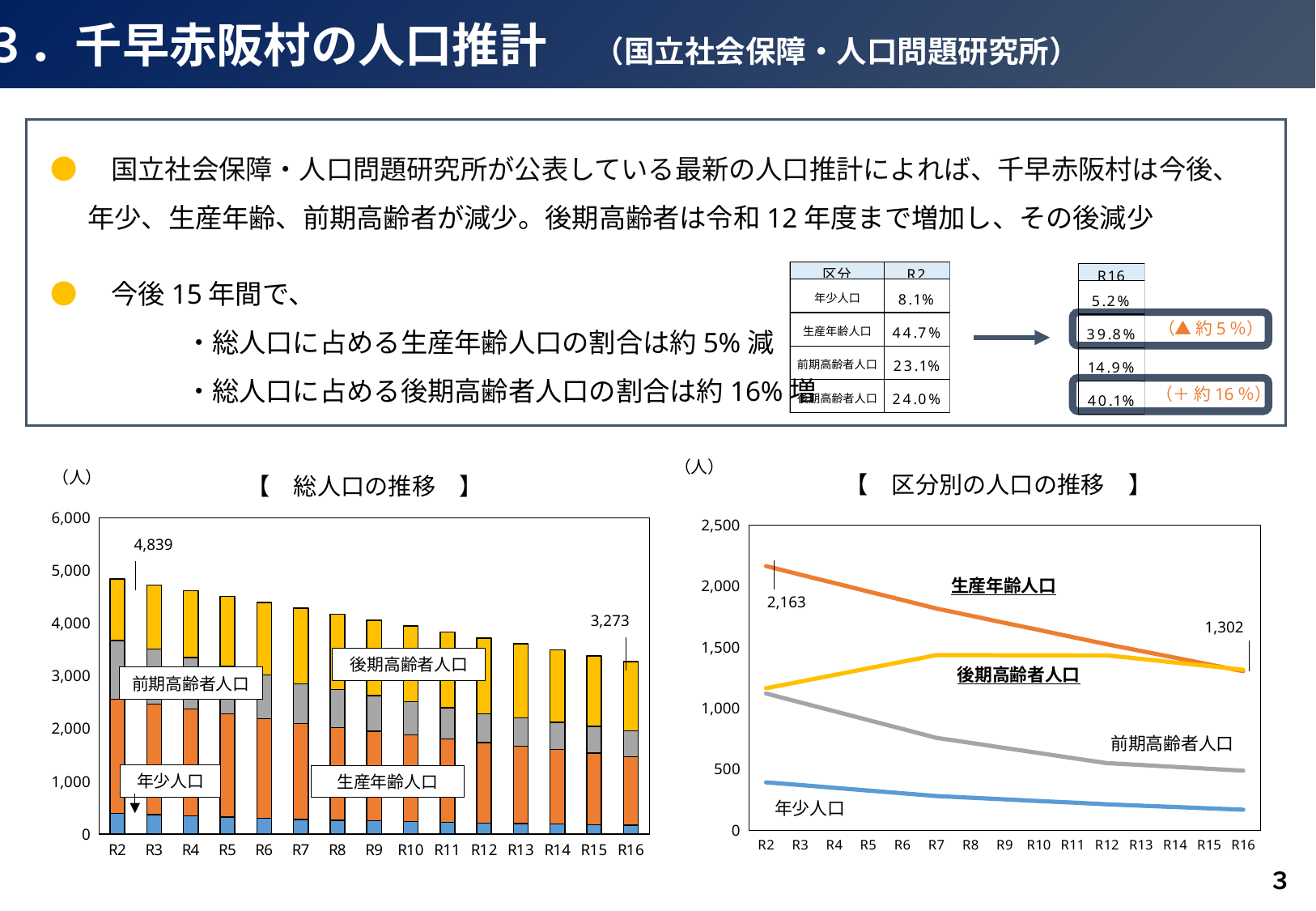
In the left chart (総人口の推移), what is the total population shown for R2? 4,839 In the left chart (総人口の推移), what is the total population shown for R16? 3,273 In the right chart (区分別の人口の推移), is the value of 前期高齢者人口 at R2 greater or less than 1,000? greater In the left chart (総人口の推移), what is the difference between the R2 total and the R16 total? 1,566 In the right chart (区分別の人口の推移), what is the value of 生産年齢人口 at R2? 2,163 In the right chart (区分別の人口の推移), which category has the lowest value at R2? 年少人口 In the left chart (総人口の推移), is the total for R12 greater or less than 4,000? less What kind of chart is the left chart titled 総人口の推移? stacked bar chart What kind of chart is the right chart titled 区分別の人口の推移? line chart In the left chart (総人口の推移), how many years are shown on the x axis? 15 In the left chart (総人口の推移), do the total bar heights rise or fall from R2 to R16? fall In the right chart (区分別の人口の推移), what is the value of 生産年齢人口 at R16? 1,302